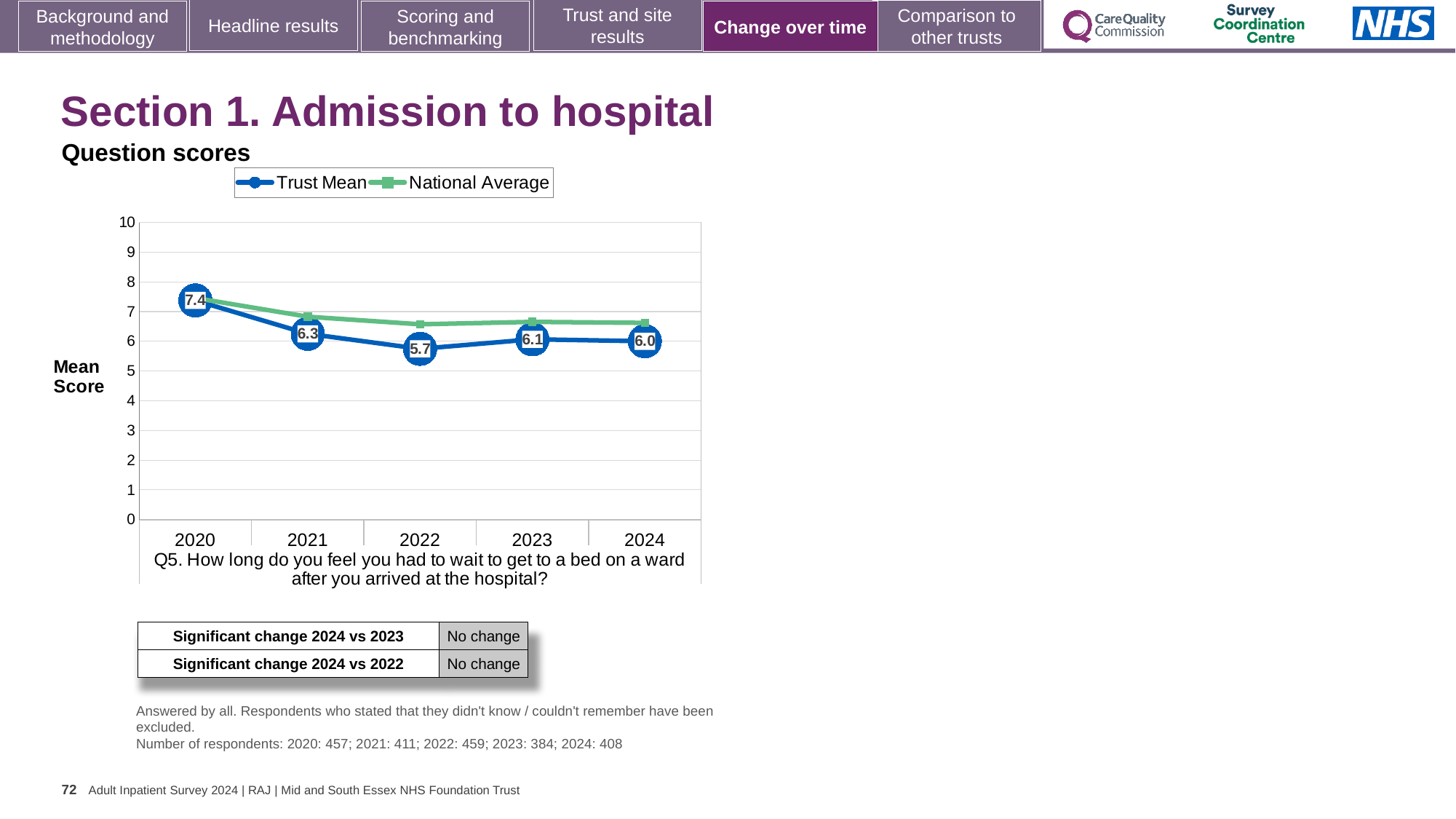
In 2022, which series has the higher value, Trust Mean or National Average? National Average How many series does the chart legend list? 2 Is the National Average value for 2022 greater or less than 6? greater In which year is the Trust Mean score lowest? 2022 In which year is the Trust Mean score highest? 2020 What is the Trust Mean score for 2024? 6.0 What is the Trust Mean score for 2020? 7.4 Which is larger, the Trust Mean score for 2023 or for 2024? 2023 What is the difference between the Trust Mean scores for 2020 and 2021? 1.1 How many years are shown on the x axis of the chart? 5 What is the Trust Mean score for 2022? 5.7 What kind of chart is shown on the slide? Line chart